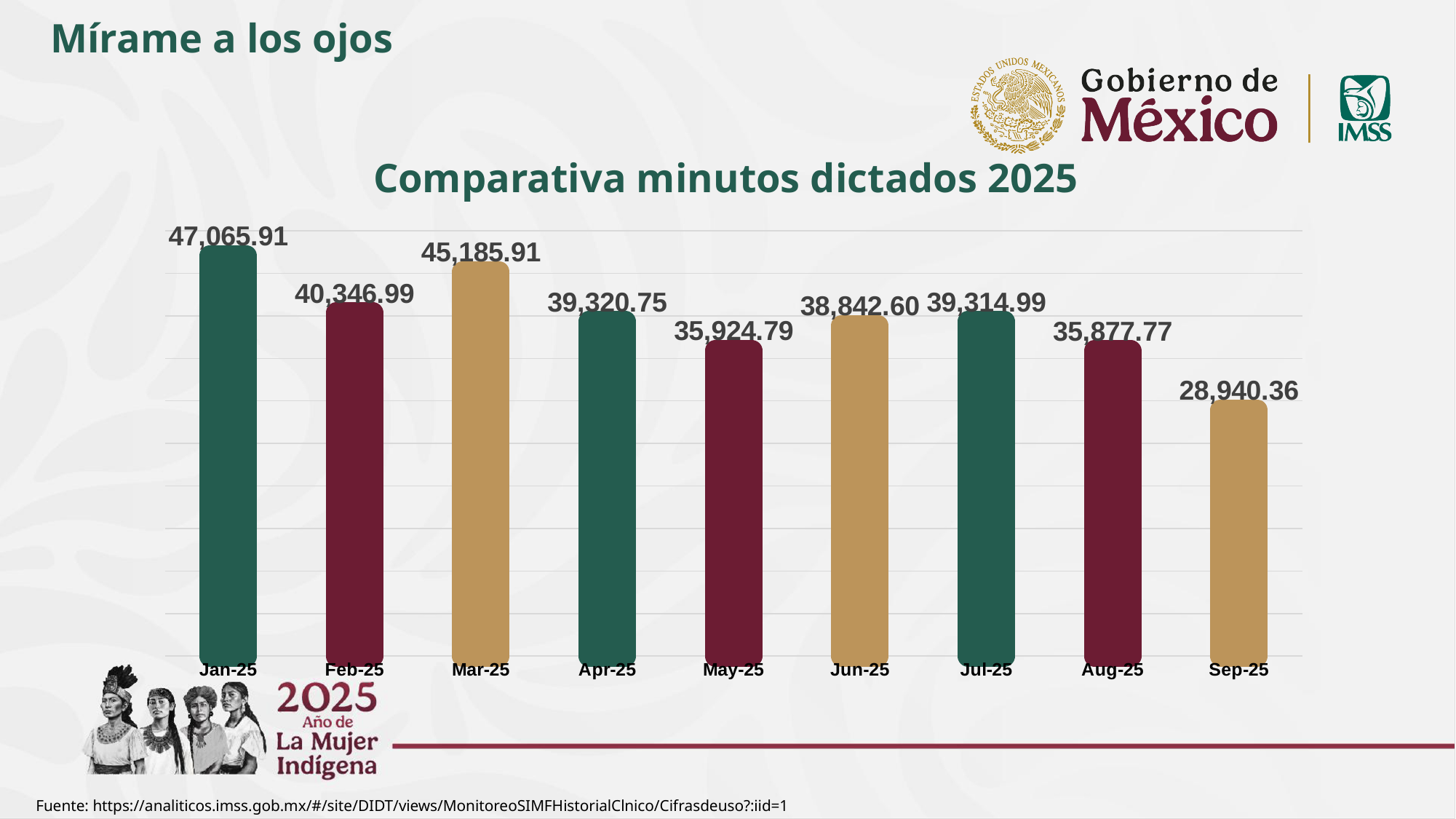
What is the difference between the values for Mar-25 and Feb-25? 4,838.92 Which is larger, the value for Feb-25 or the value for Mar-25? Mar-25 What is the difference between the values for Jan-25 and Sep-25? 18,125.55 What is the title of the chart? Comparativa minutos dictados 2025 Which is larger, the value for May-25 or the value for Jun-25? Jun-25 What is the value for Jan-25? 47,065.91 Which month has the highest value? Jan-25 What is the value for Jun-25? 38,842.60 How many months are shown on the chart? 9 Which month has the lowest value? Sep-25 What kind of chart is this? Bar chart What is the value for Sep-25? 28,940.36